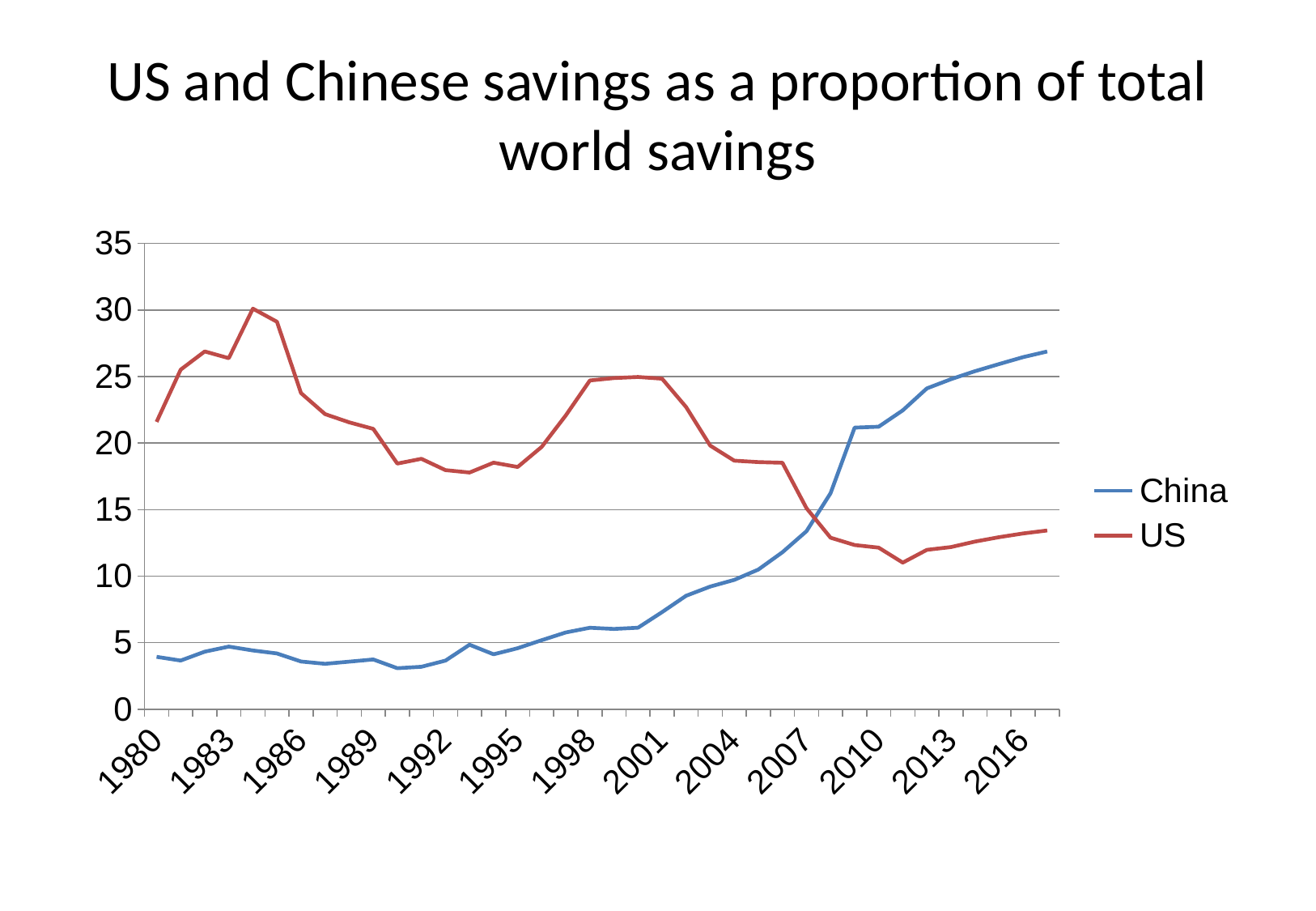
Is the value for China in 2016 greater or less than 25? greater Is the value for US in 1998 greater or less than 20? greater Is the value for US in 2016 greater or less than 15? less In 2016, which series has the larger value, China or US? China In 1980, which series has the larger value, China or US? US How many series does the legend list? 2 Does the China line generally rise or fall from 1980 to 2016? rise What is the title of the chart? US and Chinese savings as a proportion of total world savings What kind of chart is shown on the slide? line chart Which colour is used for the China line? blue